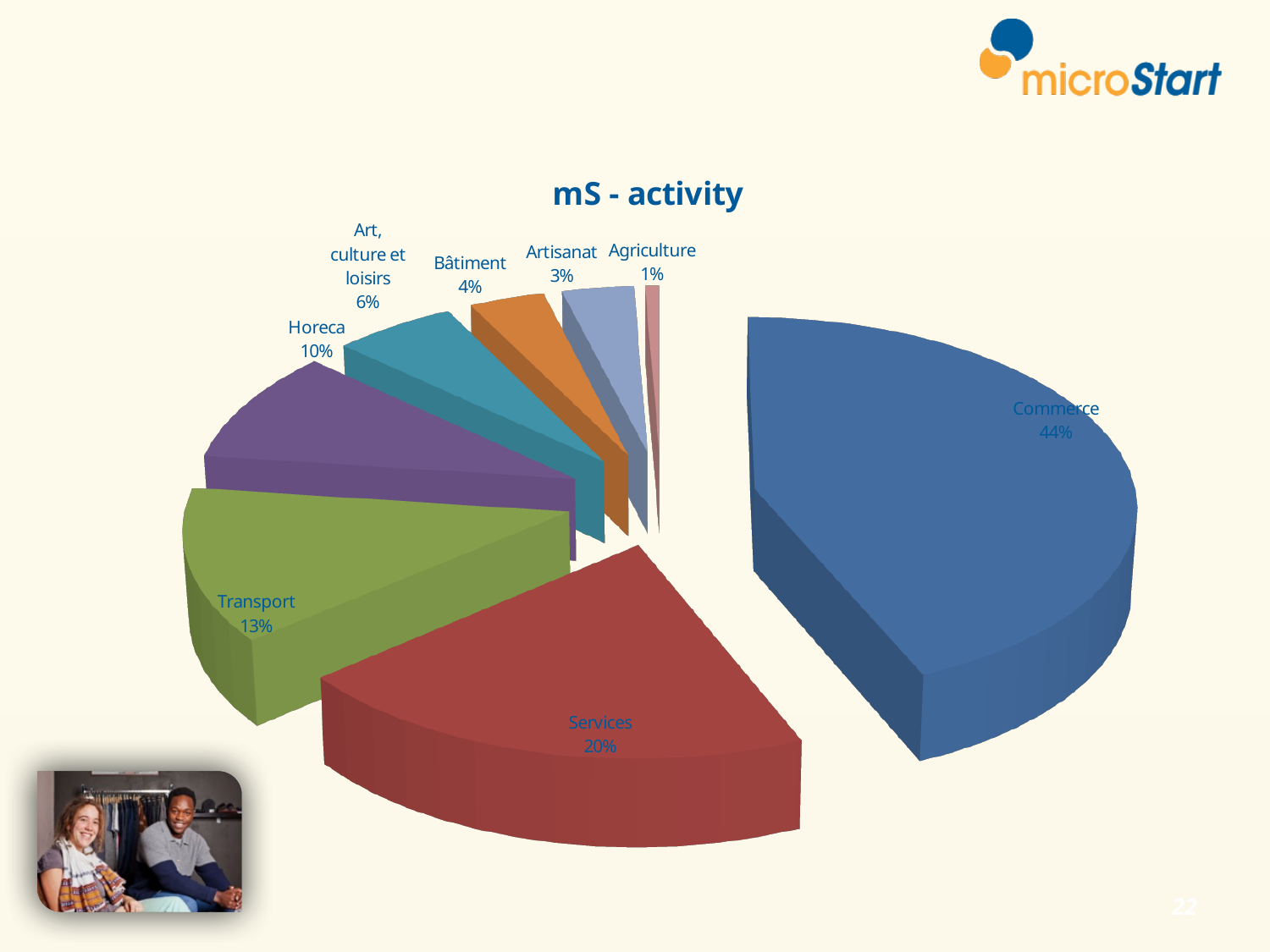
What is the value shown for Art, culture et loisirs? 6% How many categories are shown in the pie chart? 8 What share of the pie does Commerce represent? 44% What kind of chart is shown on the slide? Pie chart What is the title of the chart? mS - activity What is the value shown for Horeca? 10% Which is larger, the share for Bâtiment or the share for Artisanat? Bâtiment What is the value shown for Transport? 13% What is the value shown for Services? 20% Which category has the largest share of the pie? Commerce Which category has the smallest share of the pie? Agriculture What is the difference between the shares of Commerce and Services? 24%